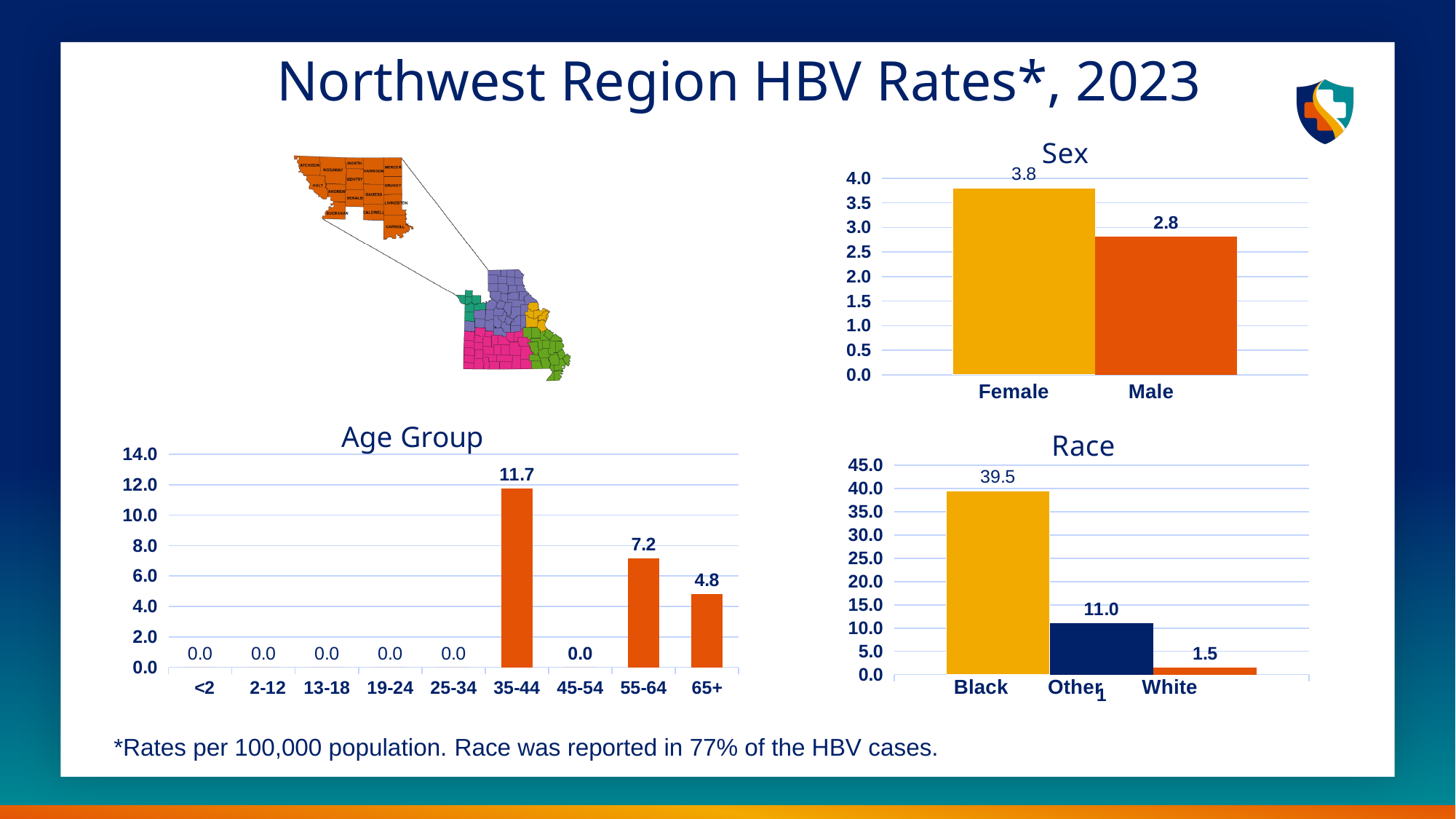
In the Age Group chart, which age group has the highest rate? 35-44 In the Age Group chart, what is the rate for the 45-54 age group? 0.0 In the Race chart, which category has the lowest rate? White In the Sex chart, what is the difference between the Female and Male rates? 1.0 What kind of chart is the Race chart? Bar chart In the Race chart, is the rate for Other greater or less than 10.0? greater In the Age Group chart, what is the difference between the 55-64 and 65+ rates? 2.4 In the Age Group chart, what is the rate for the 35-44 age group? 11.7 In the Age Group chart, how many age group categories are shown on the x axis? 9 In the Sex chart, what is the HBV rate for Female? 3.8 In the Race chart, what is the rate for Black? 39.5 In the Sex chart, what is the HBV rate for Male? 2.8